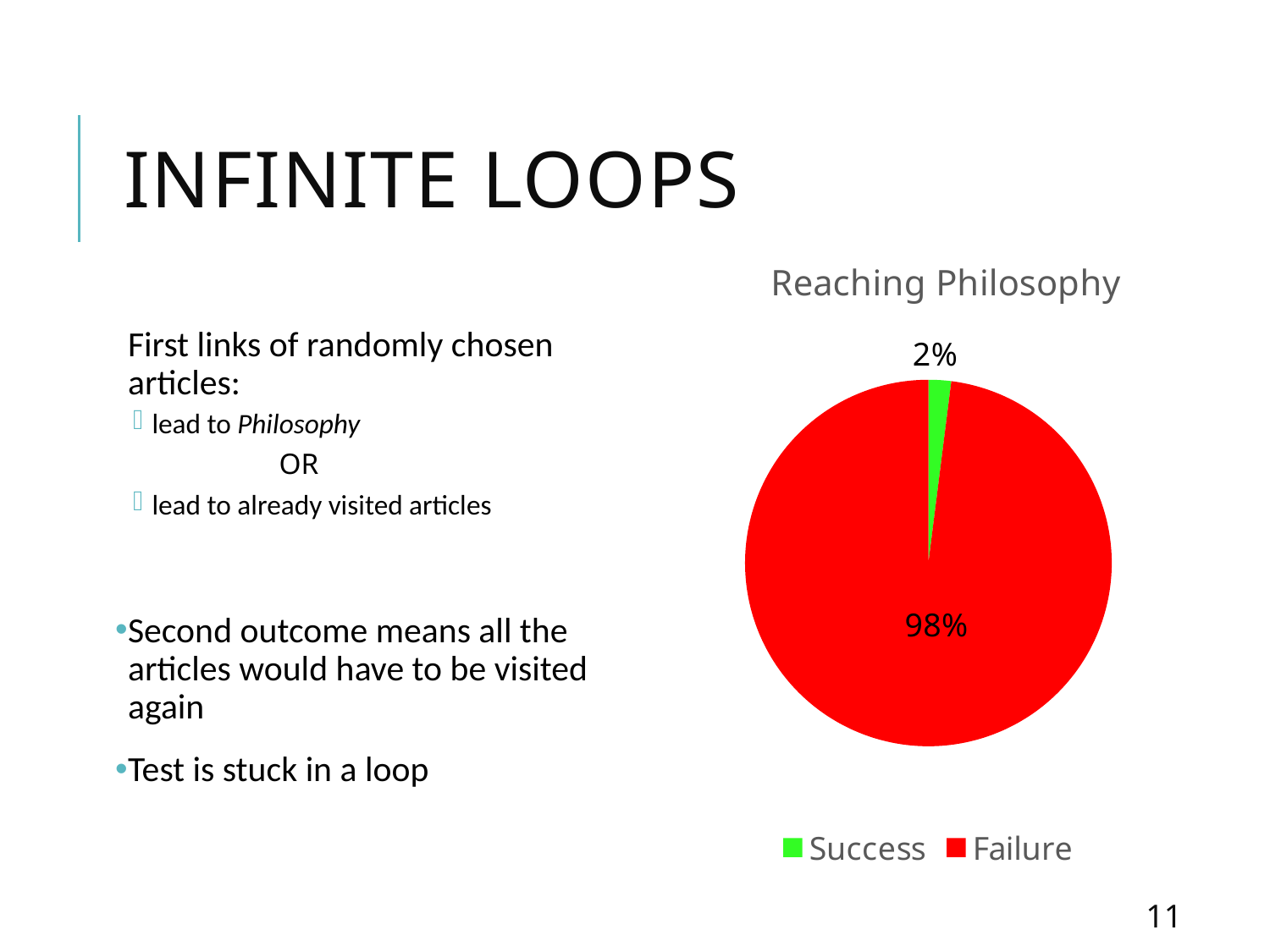
What share of the pie does Failure represent? 98% How many slices does the pie chart have? 2 How many entries does the legend list? 2 What share of the pie does Success represent? 2% What colour is the Success slice in the pie chart? green What is the title of the chart? Reaching Philosophy Which is larger, the Success slice or the Failure slice? Failure Which slice is the largest in the pie chart? Failure Which slice is the smallest in the pie chart? Success What kind of chart is shown on the slide? pie chart What is the difference in percentage points between the Failure and Success slices? 96